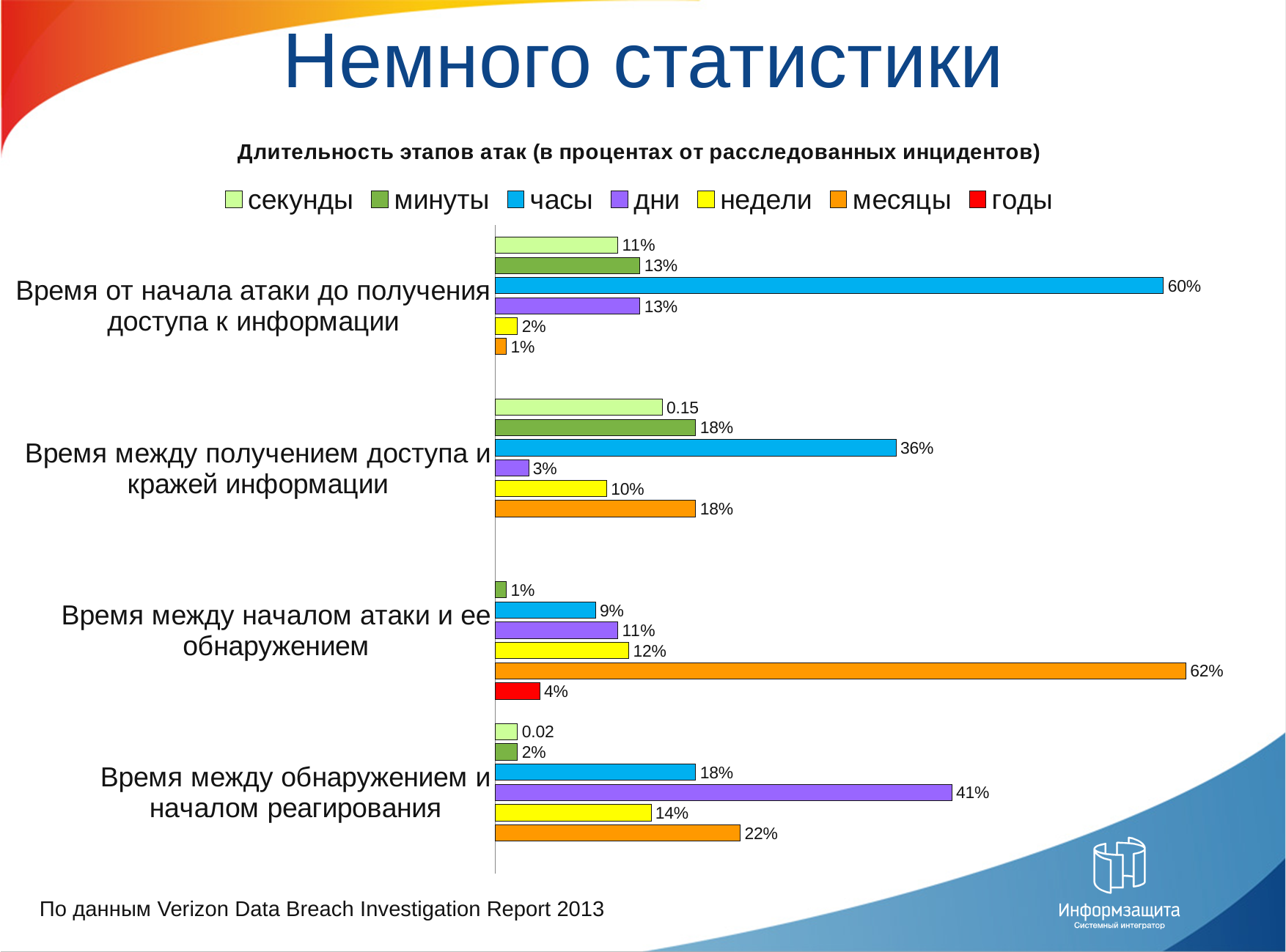
What type of chart is shown on the slide? Bar chart What is the value for "месяцы" in the category "Время между началом атаки и ее обнаружением"? 62% Which series has the lowest value in the category "Время от начала атаки до получения доступа к информации"? месяцы Which series has the highest value in the category "Время между получением доступа и кражей информации"? часы What is the value for "годы" in the category "Время между началом атаки и ее обнаружением"? 4% What is the difference between the "часы" value and the "минуты" value in the category "Время между получением доступа и кражей информации"? 18% What is the value for "дни" in the category "Время между обнаружением и началом реагирования"? 41% What is the value for "часы" in the category "Время от начала атаки до получения доступа к информации"? 60% What is the title of the chart? Длительность этапов атак (в процентах от расследованных инцидентов) How many categories (attack stages) are shown on the chart? 4 How many series does the legend list? 7 In the category "Время между обнаружением и началом реагирования", which is larger: the value for "месяцы" or the value for "недели"? месяцы